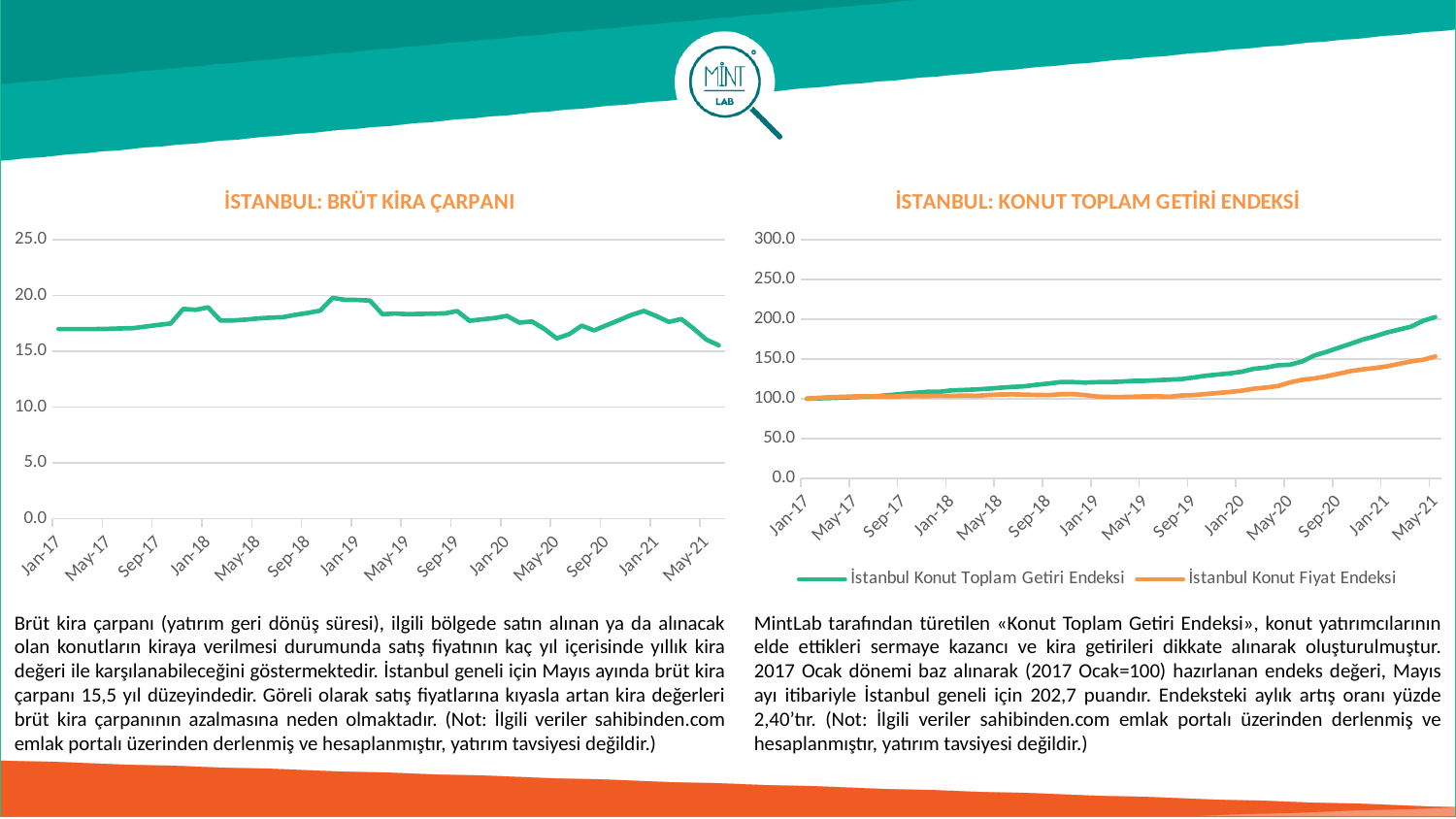
What type of chart is the chart titled 'İSTANBUL: KONUT TOPLAM GETİRİ ENDEKSİ'? Line chart In the chart titled 'İSTANBUL: BRÜT KİRA ÇARPANI', is the value for May-21 greater or less than 20.0? less In the chart titled 'İSTANBUL: BRÜT KİRA ÇARPANI', is the value for Jan-19 greater or less than 15.0? greater What type of chart is the chart titled 'İSTANBUL: BRÜT KİRA ÇARPANI'? Line chart In the chart titled 'İSTANBUL: KONUT TOPLAM GETİRİ ENDEKSİ', is the value of İstanbul Konut Fiyat Endeksi for May-21 greater or less than 200.0? less How many series does the legend of the chart titled 'İSTANBUL: KONUT TOPLAM GETİRİ ENDEKSİ' list? 2 In the chart titled 'İSTANBUL: KONUT TOPLAM GETİRİ ENDEKSİ', which series is shown in orange? İstanbul Konut Fiyat Endeksi In the chart titled 'İSTANBUL: KONUT TOPLAM GETİRİ ENDEKSİ', do the values of İstanbul Konut Toplam Getiri Endeksi rise or fall from Jan-17 to May-21? rise In the chart titled 'İSTANBUL: BRÜT KİRA ÇARPANI', which is higher, the value for Jan-19 or the value for May-21? Jan-19 What is the title of the chart on the left side of the slide? İSTANBUL: BRÜT KİRA ÇARPANI In the chart titled 'İSTANBUL: KONUT TOPLAM GETİRİ ENDEKSİ', which series has the higher value at May-21? İstanbul Konut Toplam Getiri Endeksi